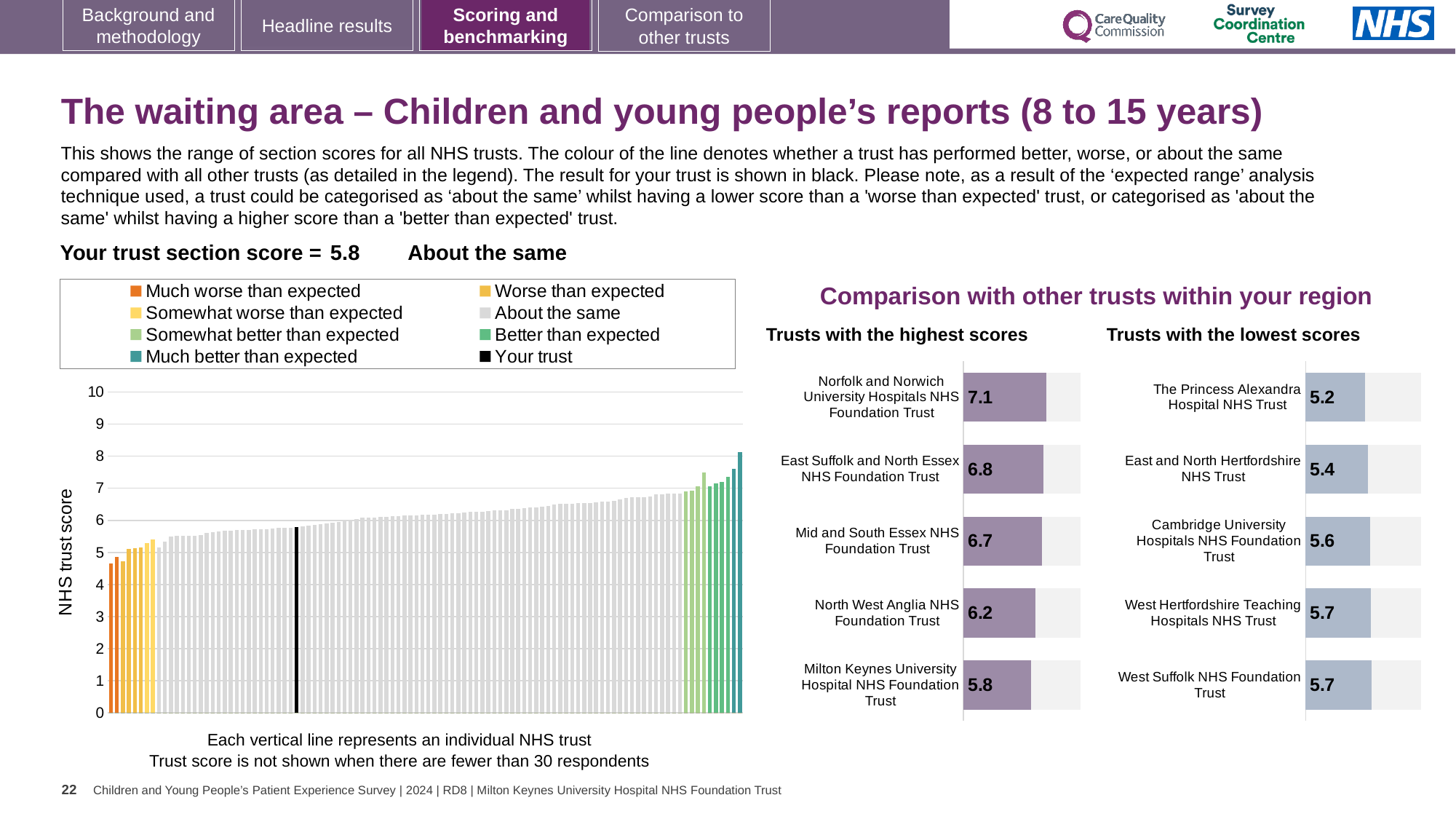
In the NHS trust score chart on the left, do the bar values rise or fall from left to right? rise How many entries does the legend of the NHS trust score chart on the left list? 8 How many trusts are listed in the 'Trusts with the lowest scores' chart? 5 In the 'Trusts with the highest scores' chart, which trust has the highest score? Norfolk and Norwich University Hospitals NHS Foundation Trust In the 'Trusts with the highest scores' chart, what is the score for Norfolk and Norwich University Hospitals NHS Foundation Trust? 7.1 In the 'Trusts with the lowest scores' chart, which has the larger score: East and North Hertfordshire NHS Trust or West Hertfordshire Teaching Hospitals NHS Trust? West Hertfordshire Teaching Hospitals NHS Trust In the 'Trusts with the highest scores' chart, what is the score for North West Anglia NHS Foundation Trust? 6.2 In the 'Trusts with the lowest scores' chart, which trust has the lowest score? The Princess Alexandra Hospital NHS Trust In the NHS trust score chart on the left, what is the score for 'Your trust' (the black bar)? 5.8 In the 'Trusts with the lowest scores' chart, what is the score for The Princess Alexandra Hospital NHS Trust? 5.2 In the 'Trusts with the lowest scores' chart, what is the score for Cambridge University Hospitals NHS Foundation Trust? 5.6 In the 'Trusts with the highest scores' chart, what is the difference between the scores of Norfolk and Norwich University Hospitals NHS Foundation Trust and Milton Keynes University Hospital NHS Foundation Trust? 1.3